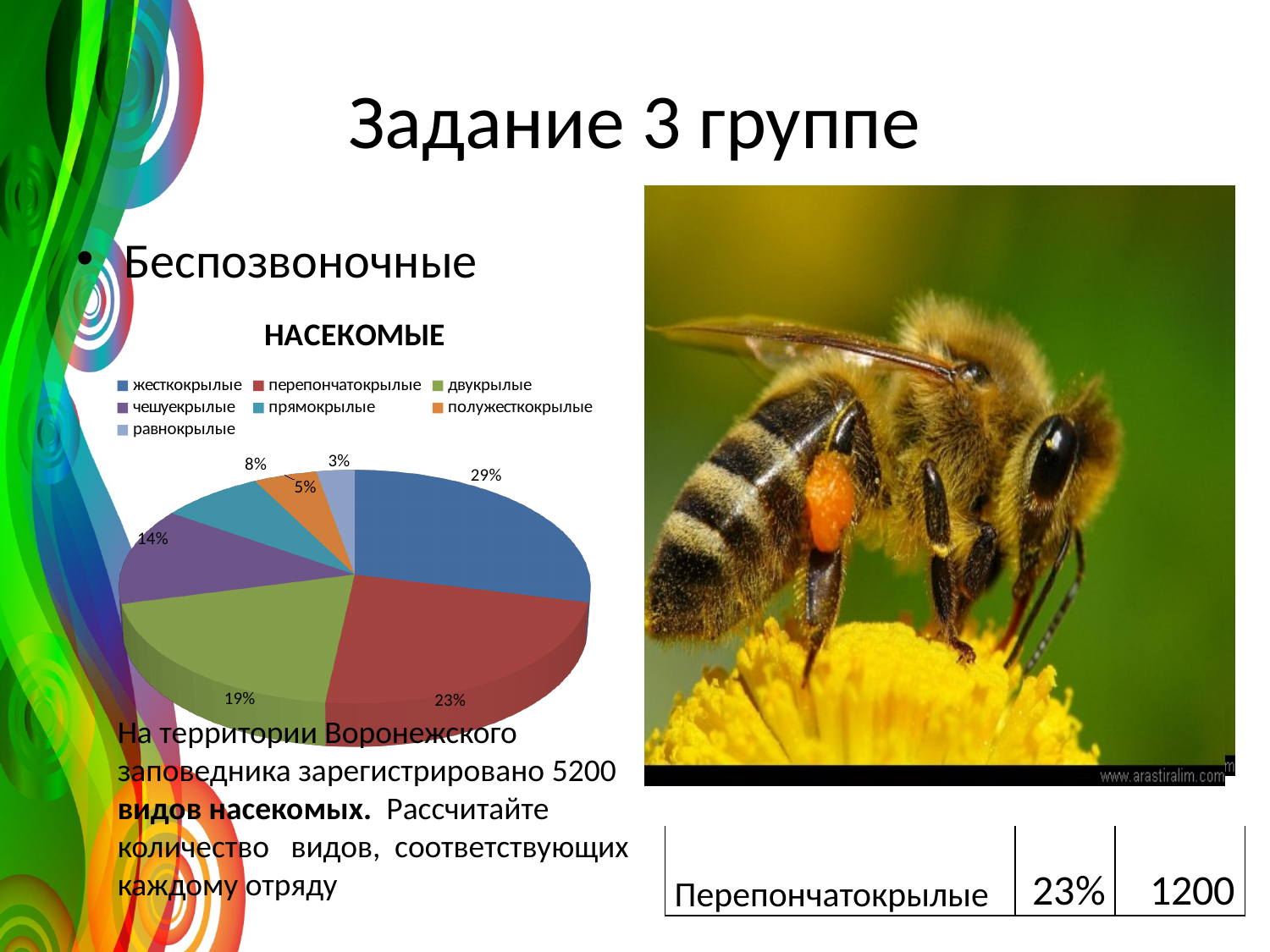
In the НАСЕКОМЫЕ pie chart, what share is shown for жесткокрылые? 29% What kind of chart is shown under the heading НАСЕКОМЫЕ? pie chart How many orders (slices) does the НАСЕКОМЫЕ pie chart show? 7 In the НАСЕКОМЫЕ pie chart, what share is shown for чешуекрылые? 14% In the НАСЕКОМЫЕ pie chart, which is larger: the share of прямокрылые or the share of полужесткокрылые? прямокрылые In the НАСЕКОМЫЕ pie chart, what is the difference between the shares of жесткокрылые and перепончатокрылые? 6% In the НАСЕКОМЫЕ pie chart, what share is shown for двукрылые? 19% What colour is the slice for перепончатокрылые in the НАСЕКОМЫЕ pie chart? red Which order has the largest slice in the НАСЕКОМЫЕ pie chart? жесткокрылые Which order has the smallest slice in the НАСЕКОМЫЕ pie chart? равнокрылые In the НАСЕКОМЫЕ pie chart, what share is shown for перепончатокрылые? 23% In the НАСЕКОМЫЕ pie chart, what share is shown for равнокрылые? 3%